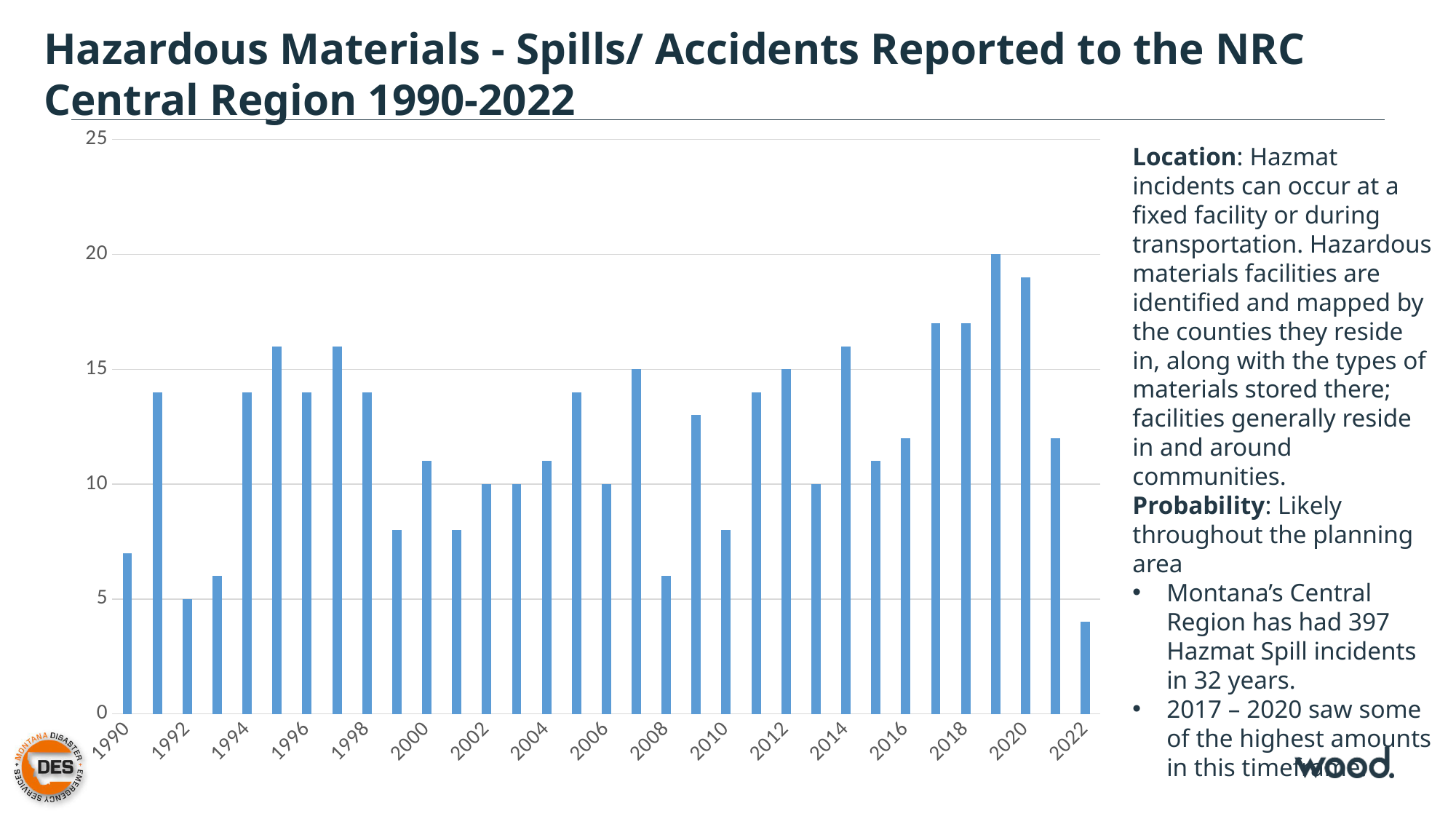
Is the value for 1990 greater or less than 10? less How many spills/accidents were reported in 2019? 20 How many years (bars) are plotted in the chart? 33 Do the values rise or fall from 2016 to 2019? rise How many spills/accidents were reported in 2007? 15 Is the value for 2008 greater or less than 10? less Which year has the larger value, 1991 or 1992? 1991 Which year has the highest number of spills/accidents reported? 2019 How many spills/accidents were reported in 1992? 5 What kind of chart is shown on the slide? bar chart Is the value for 2020 greater or less than 15? greater How many spills/accidents were reported in 2002? 10